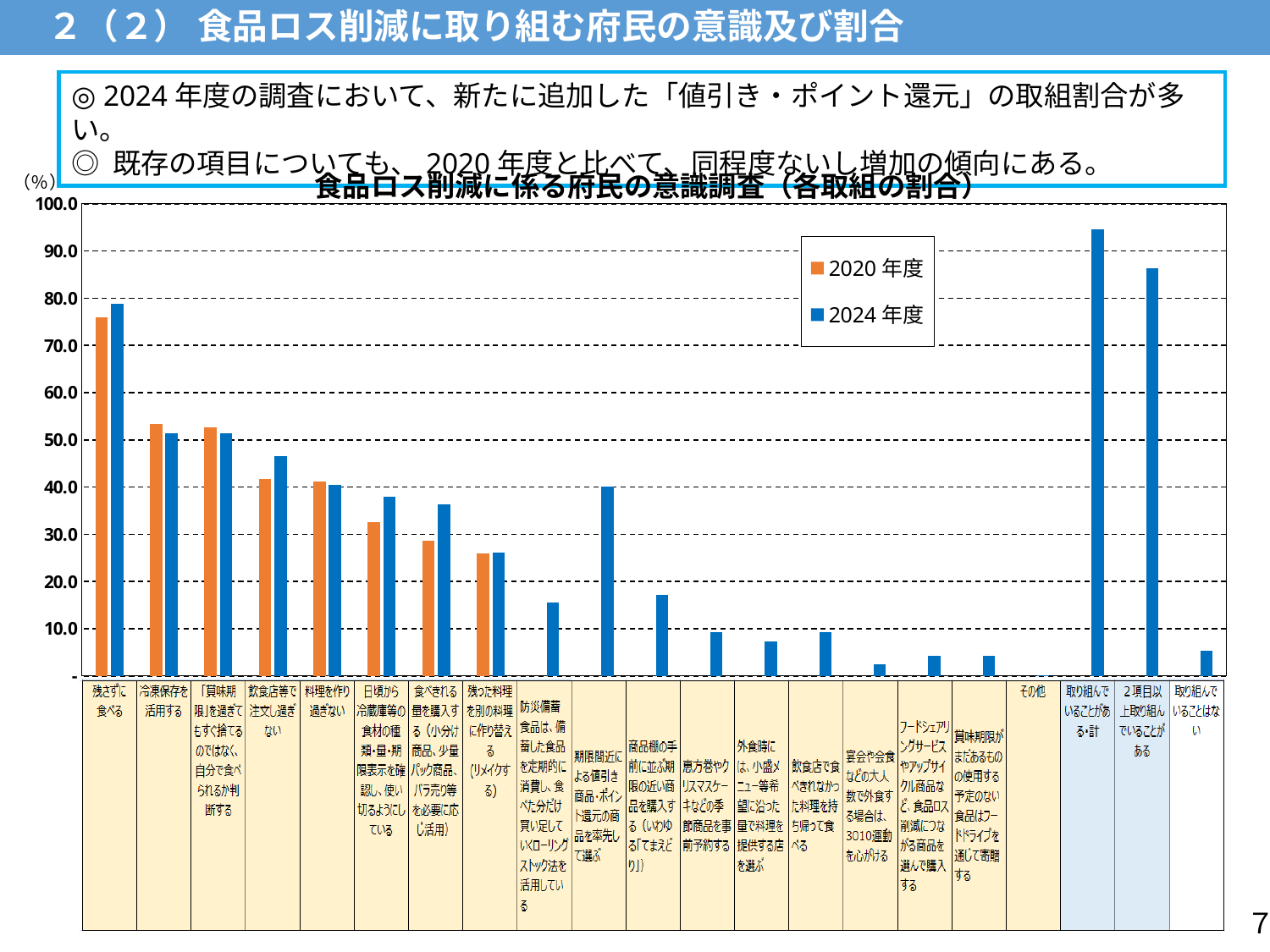
How many series does the legend list? 2 Is the 2024年度 value for 取り組んでいることがある・計 greater or less than 90.0? greater Which category has the highest 2020年度 value? 残さずに食べる What is the title of the chart? 食品ロス削減に係る府民の意識調査（各取組の割合） Is the 2024年度 value for 取り組んでいることはない greater or less than 10.0? less Which category has the highest 2024年度 value? 取り組んでいることがある・計 For 飲食店等で注文し過ぎない, which series has the larger value, 2020年度 or 2024年度? 2024年度 What kind of chart is shown on the slide? bar chart Is the 2024年度 value for 期限間近による値引き商品・ポイント還元の商品を率先して選ぶ greater or less than 30.0? greater For 食べきれる量を購入する, which series has the larger value, 2020年度 or 2024年度? 2024年度 What are the two series named in the legend? 2020年度 and 2024年度